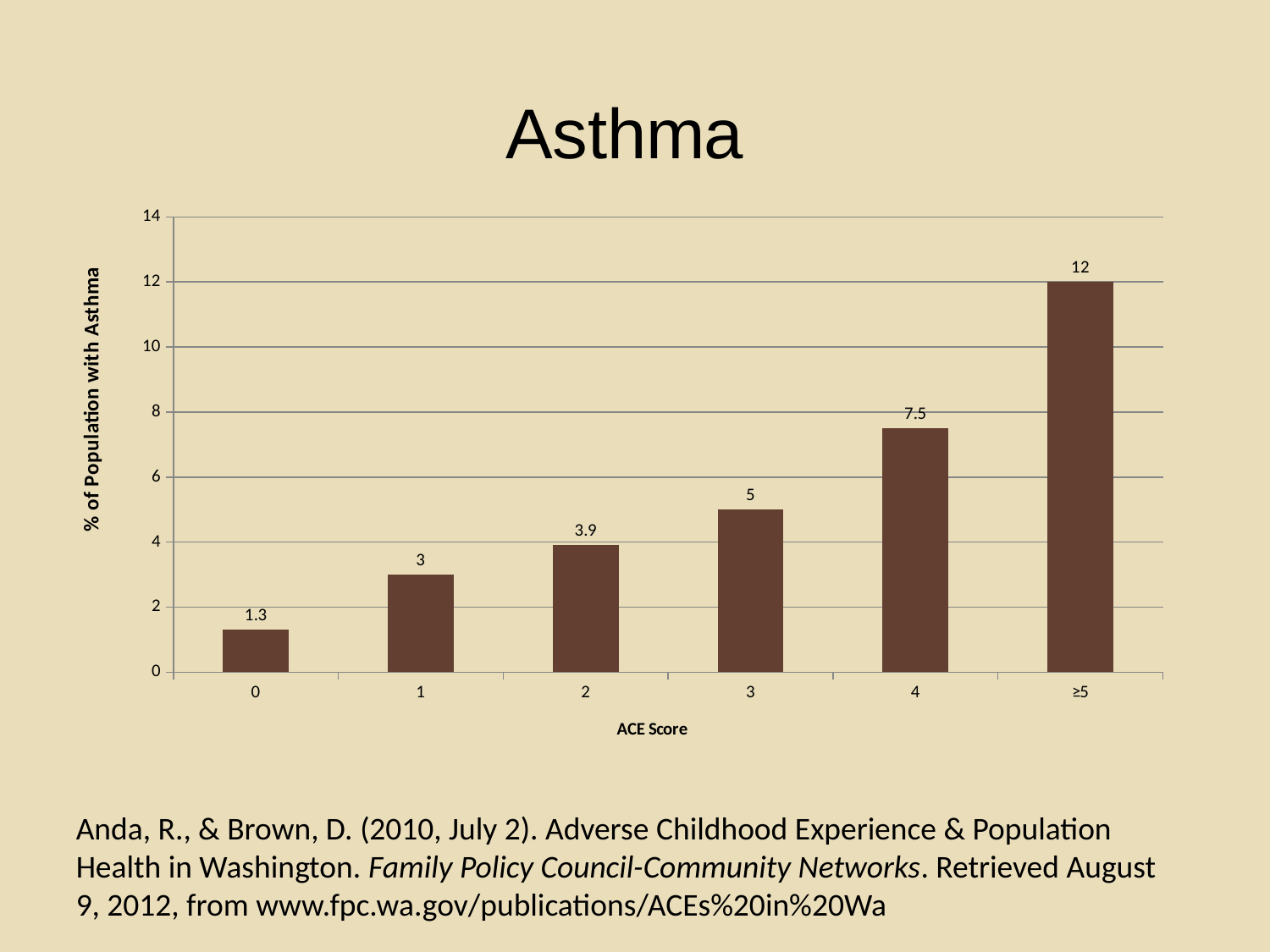
What percentage of the population with an ACE score of 0 has asthma? 1.3 What is the difference between the values for ACE score ≥5 and ACE score 0? 10.7 Which ACE score category has the lowest percentage of population with asthma? 0 What is the value shown for an ACE score of 4? 7.5 How many ACE score categories are shown on the chart? 6 What is the difference between the values for ACE score 4 and ACE score 3? 2.5 What is the value shown for an ACE score of 2? 3.9 Which ACE score category has the highest percentage of population with asthma? ≥5 Which is larger, the value for ACE score 1 or ACE score 3? ACE score 3 What is the value shown for an ACE score of ≥5? 12 What kind of chart is shown on the slide? Bar chart Do the values rise or fall as the ACE score increases along the x axis? Rise